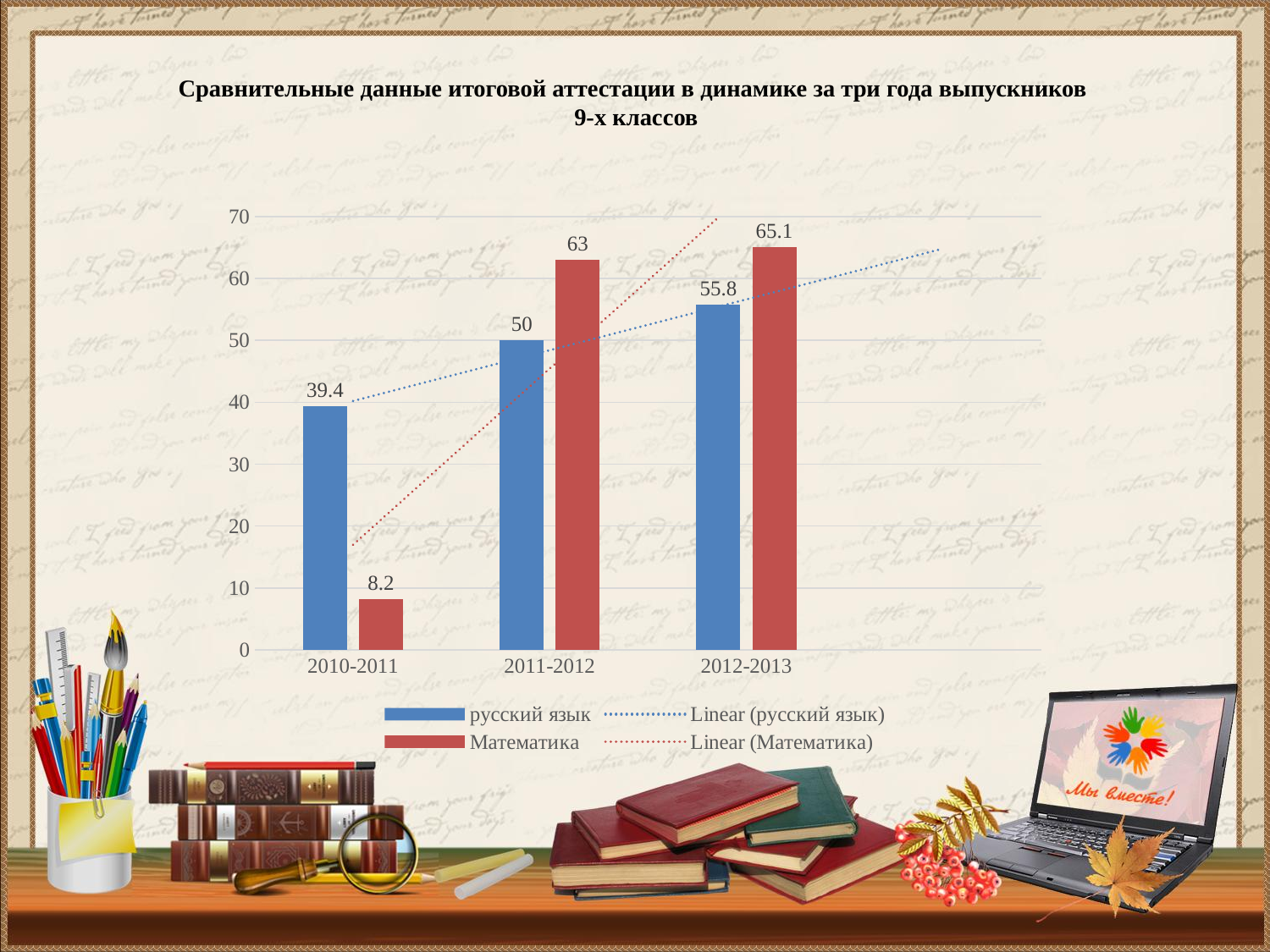
What is the value for Математика in 2012-2013? 65.1 Do the values for Математика rise or fall from 2010-2011 to 2012-2013? rise What kind of chart is shown on the slide? bar chart In which year is the value for русский язык highest? 2012-2013 What is the difference between the Математика and русский язык values in 2010-2011? 31.2 In which year is the value for Математика lowest? 2010-2011 What is the value for русский язык in 2010-2011? 39.4 How many year categories are shown on the x axis? 3 How many entries does the legend list? 4 What is the value for Математика in 2011-2012? 63 What is the value for русский язык in 2012-2013? 55.8 Which is larger in 2011-2012, русский язык or Математика? Математика